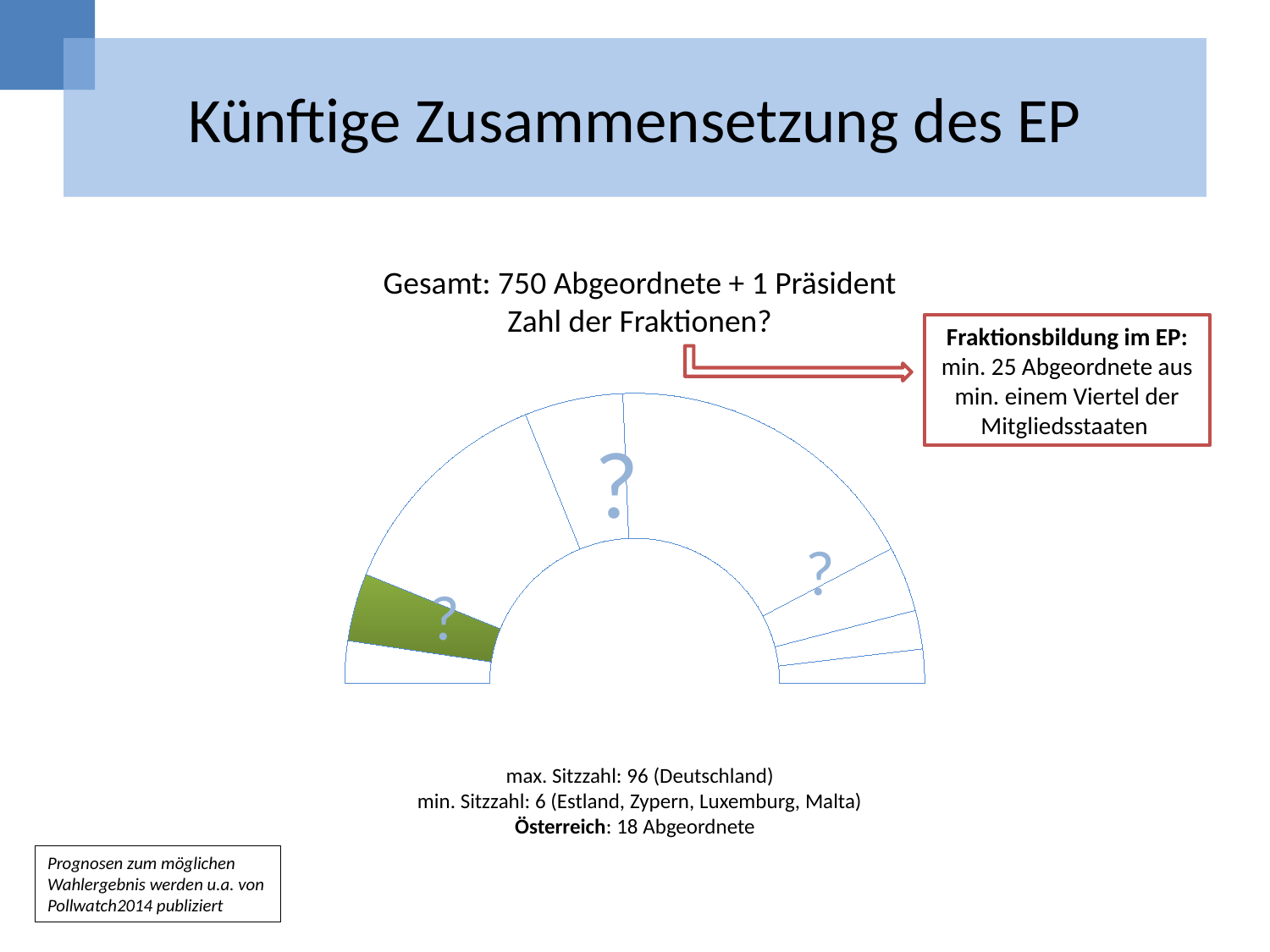
What kind of chart is shown on the slide? A semicircular (hemicycle) doughnut chart According to the red box, what is the minimum number of members needed to form a political group in the EP? min. 25 Abgeordnete According to the text above the chart, how many members does the parliament have in total? 750 Abgeordnete + 1 Präsident What is the difference between the maximum seat number (Deutschland) and the seat number for Österreich? 78 What is the minimum number of seats for a member state, as stated below the chart? 6 What is the title of the slide containing the chart? Künftige Zusammensetzung des EP How many segments of the hemicycle are filled with a colour other than white? 1 How many question marks are placed inside the chart segments? 3 What is the maximum number of seats for a member state, as stated below the chart? 96 (Deutschland) Which is larger: the seat number for Österreich or the minimum seat number? Österreich How many seats does Österreich have according to the slide? 18 Abgeordnete